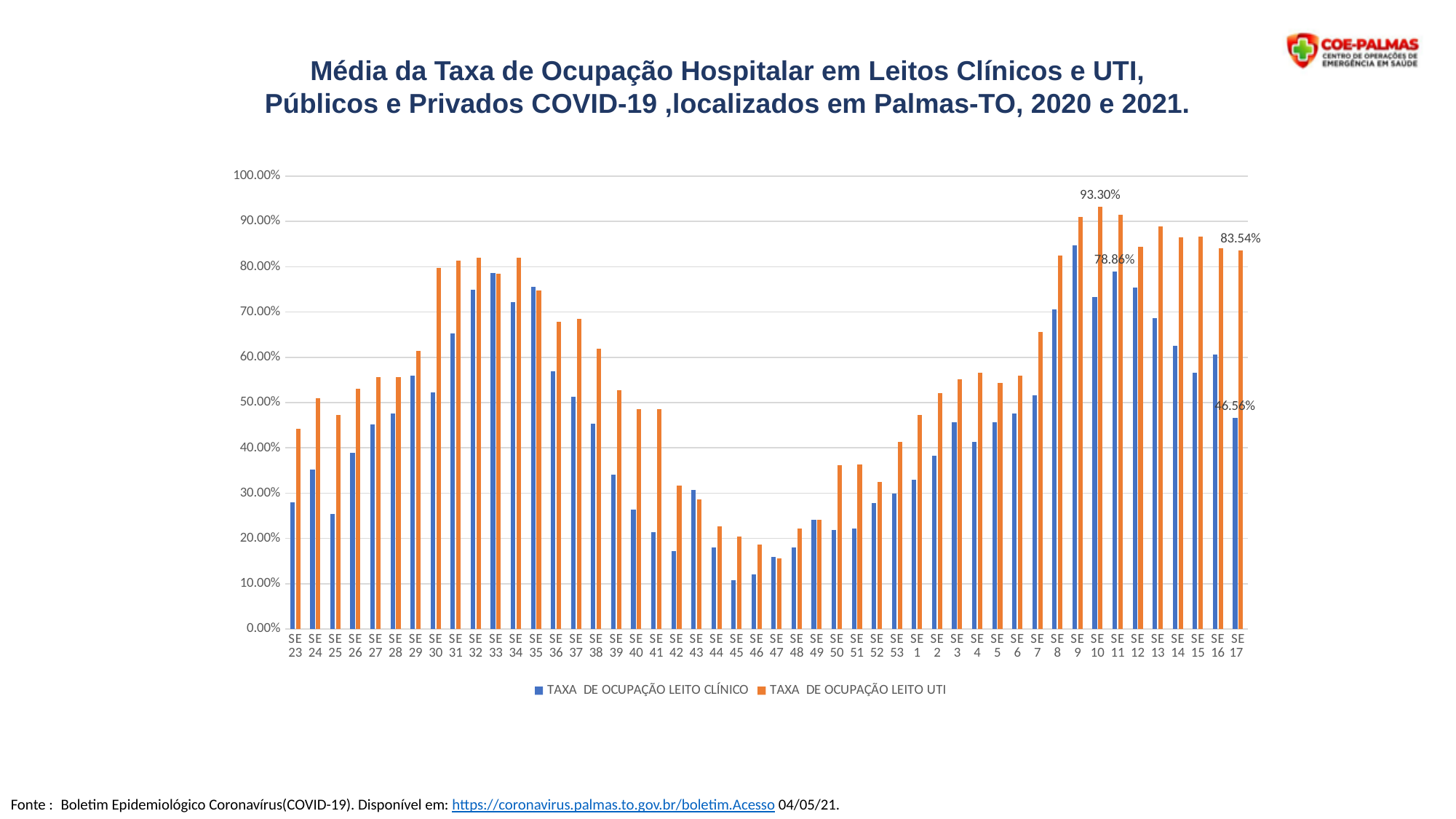
What is the value of TAXA DE OCUPAÇÃO LEITO CLÍNICO for SE 17? 46.56% What kind of chart is shown on the slide? Bar chart What is the value of TAXA DE OCUPAÇÃO LEITO UTI for SE 17? 83.54% Is the value of TAXA DE OCUPAÇÃO LEITO CLÍNICO for SE 45 greater or less than 20.00%? less In which week does TAXA DE OCUPAÇÃO LEITO UTI reach its highest value? SE 10 For SE 17, what is the difference between the UTI occupancy rate and the clinical bed occupancy rate? 36.98% What is the value of TAXA DE OCUPAÇÃO LEITO CLÍNICO for SE 11? 78.86% How many epidemiological weeks (categories) are shown on the x axis? 48 In which week is TAXA DE OCUPAÇÃO LEITO UTI at its lowest? SE 47 How many series does the legend list? 2 What is the value of TAXA DE OCUPAÇÃO LEITO UTI for SE 10? 93.30% For SE 9, which series has the larger value, TAXA DE OCUPAÇÃO LEITO CLÍNICO or TAXA DE OCUPAÇÃO LEITO UTI? TAXA DE OCUPAÇÃO LEITO UTI